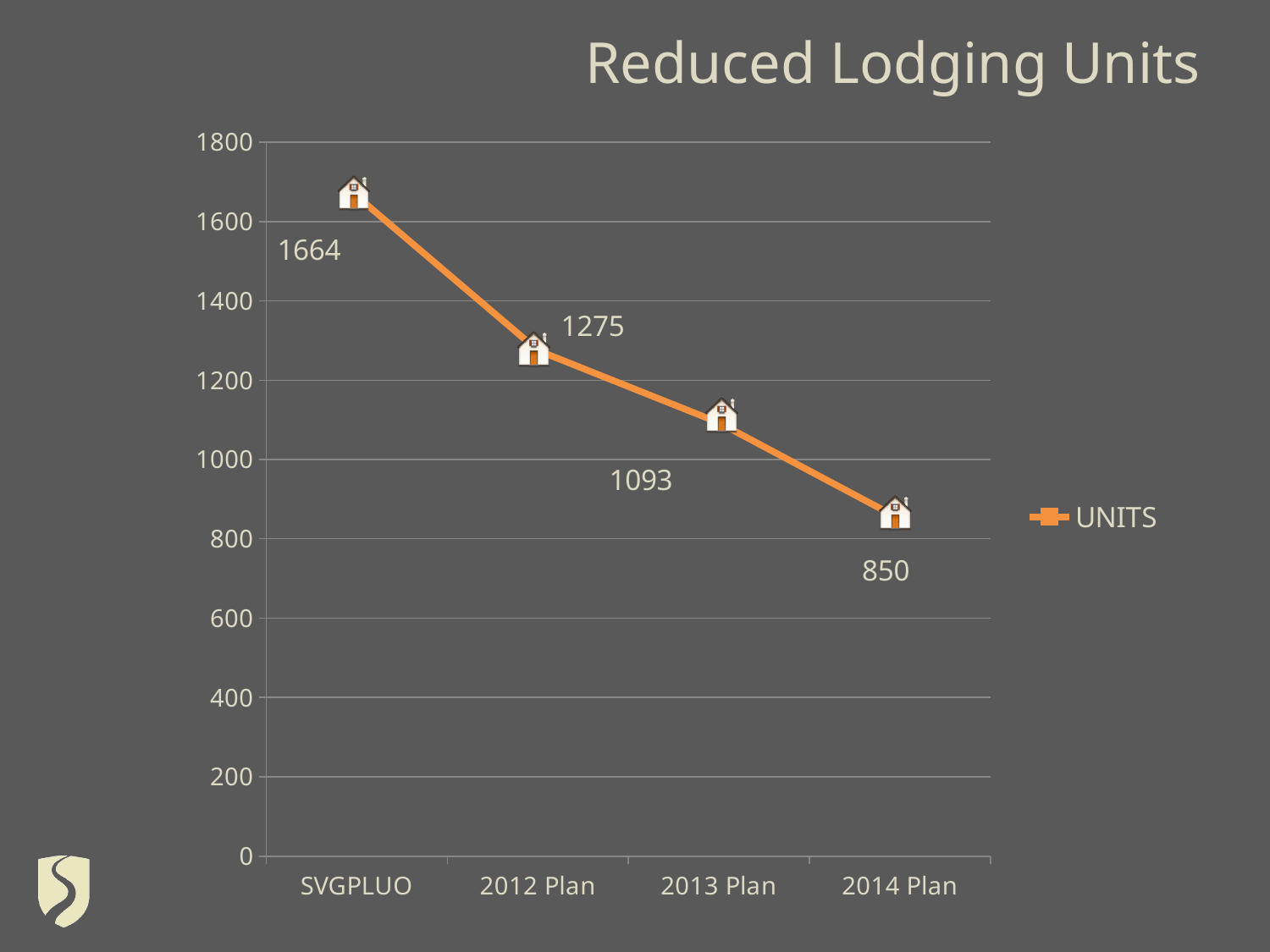
Which category has the highest value? SVGPLUO How many categories are shown on the x axis? 4 Which category has the lowest value? 2014 Plan What is the difference between the SVGPLUO value and the 2014 Plan value? 814 Do the values rise or fall from SVGPLUO to the 2014 Plan? fall Which is larger, the value for the 2012 Plan or the value for the 2013 Plan? 2012 Plan What kind of chart is shown on the slide? line chart What is the value for the 2013 Plan? 1093 What is the value for the 2012 Plan? 1275 What is the value for SVGPLUO? 1664 What is the difference between the 2012 Plan value and the 2013 Plan value? 182 What is the value for the 2014 Plan? 850